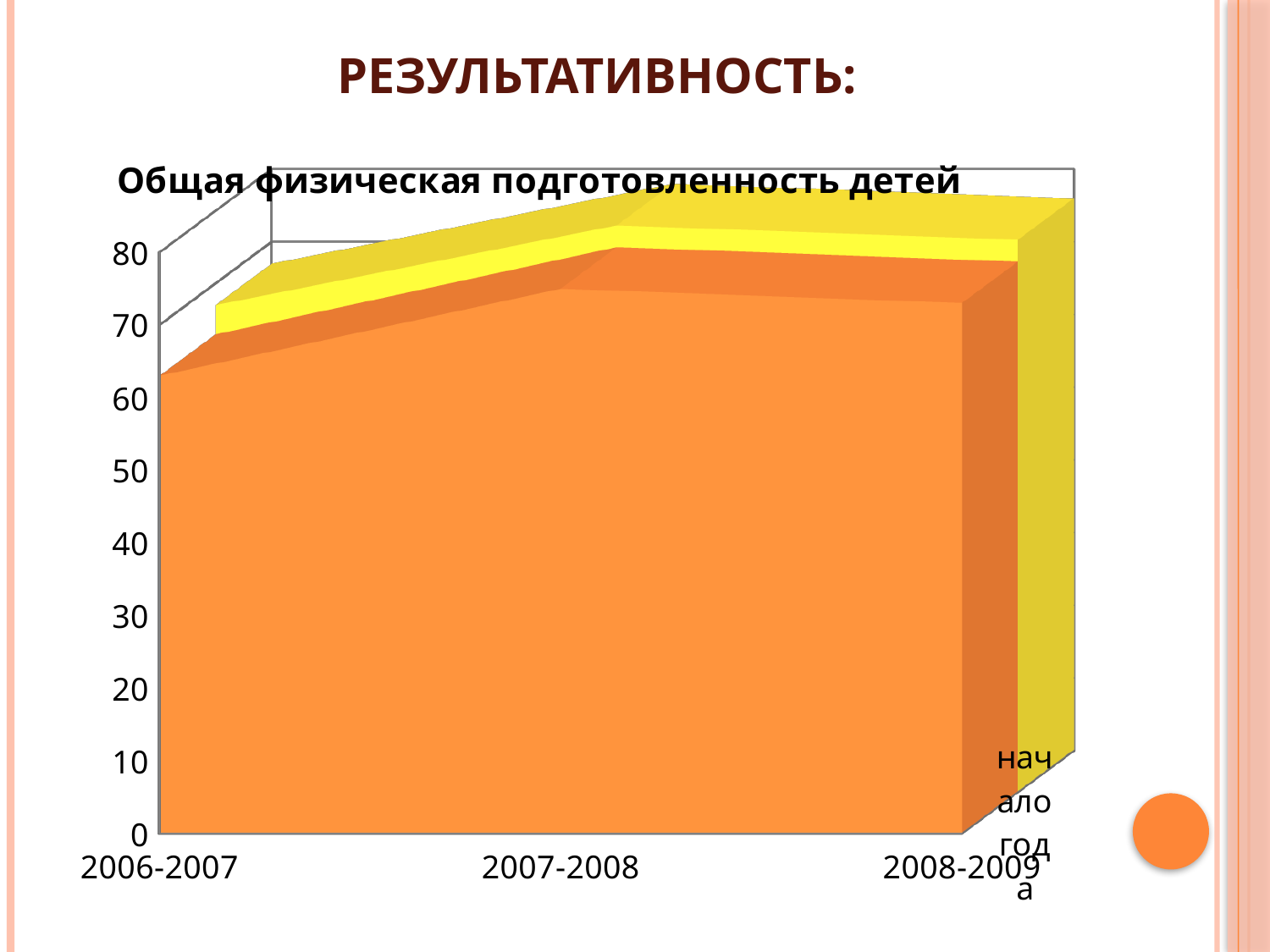
Which category is the first on the x axis of the chart? 2006-2007 What is the title of the chart? Общая физическая подготовленность детей Do the values of the front (orange) series rise or fall from 2006-2007 to 2007-2008? rise Is the value for 2008-2009 in the front (orange) series greater or less than 60? greater Which category has the lowest value in the front (orange) series? 2006-2007 Is the value for 2006-2007 in the front (orange) series greater or less than 50? greater Is the value for 2006-2007 in the front (orange) series greater or less than 70? less How many categories are shown on the x axis of the chart? 3 What kind of chart is shown on the slide? area chart Which is larger in the front (orange) series: the value for 2006-2007 or the value for 2007-2008? 2007-2008 What is the highest tick value shown on the vertical axis of the chart? 80